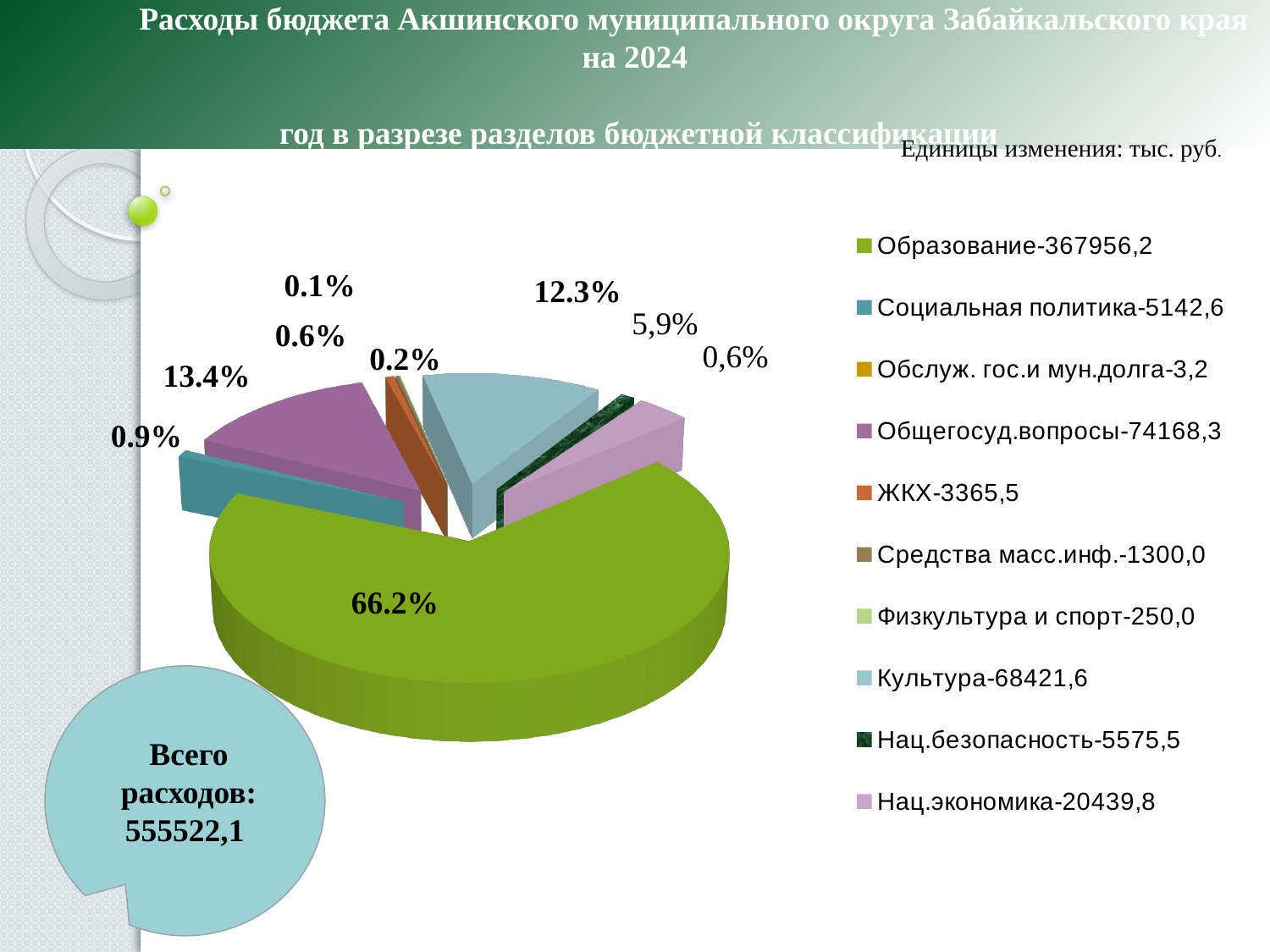
Which category has the smallest value? Обслуж. гос.и мун.долга What value is given for Культура in the legend? 68421,6 Which is larger, Культура or Общегосуд.вопросы? Общегосуд.вопросы What kind of chart is shown on the slide? pie chart What value is given for Образование in the legend? 367956,2 What total expenditure (Всего расходов) is shown on the slide? 555522,1 How many categories does the legend of the pie chart list? 10 What value is given for Общегосуд.вопросы in the legend? 74168,3 Which category has the largest value? Образование What is the difference between the values for Общегосуд.вопросы and Культура? 5746,7 What percentage share is labelled on the largest (green) slice of the pie? 66.2% What value is given for Нац.экономика in the legend? 20439,8